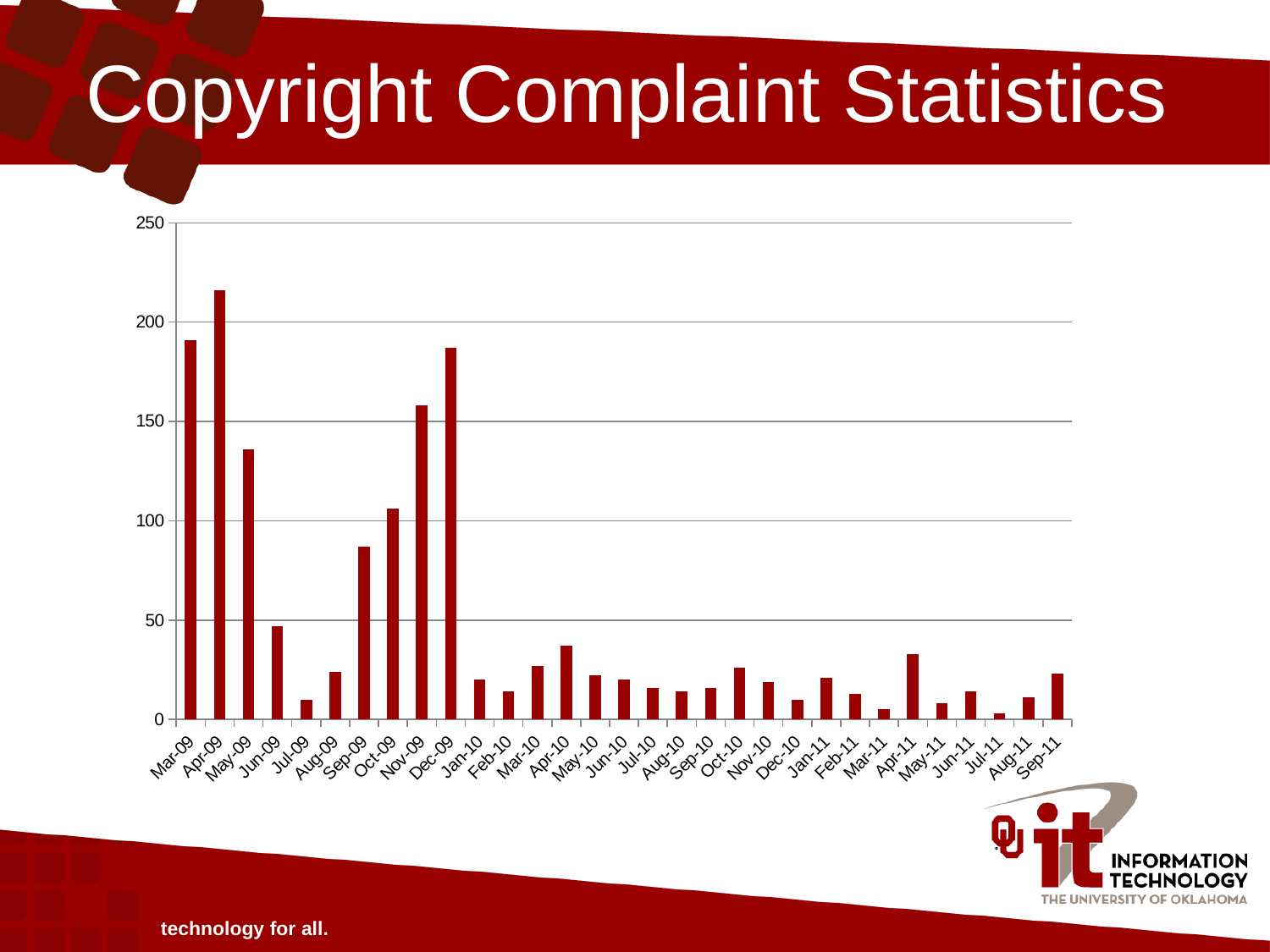
Overall, do the values rise or fall from 2009 to 2011 along the x axis? fall Is the value for Sep-09 greater or less than 100? less How many months (bars) are plotted on the chart? 31 Which is larger, the value for Dec-09 or the value for Nov-09? Dec-09 What kind of chart is shown on the slide? bar chart Is the value for Jul-09 greater or less than 50? less What is the title of the slide's chart? Copyright Complaint Statistics Which month has the lowest value on the chart? Jul-11 Is the value for Mar-09 greater or less than 150? greater Which is larger, the value for Mar-09 or the value for May-09? Mar-09 Which month has the highest value on the chart? Apr-09